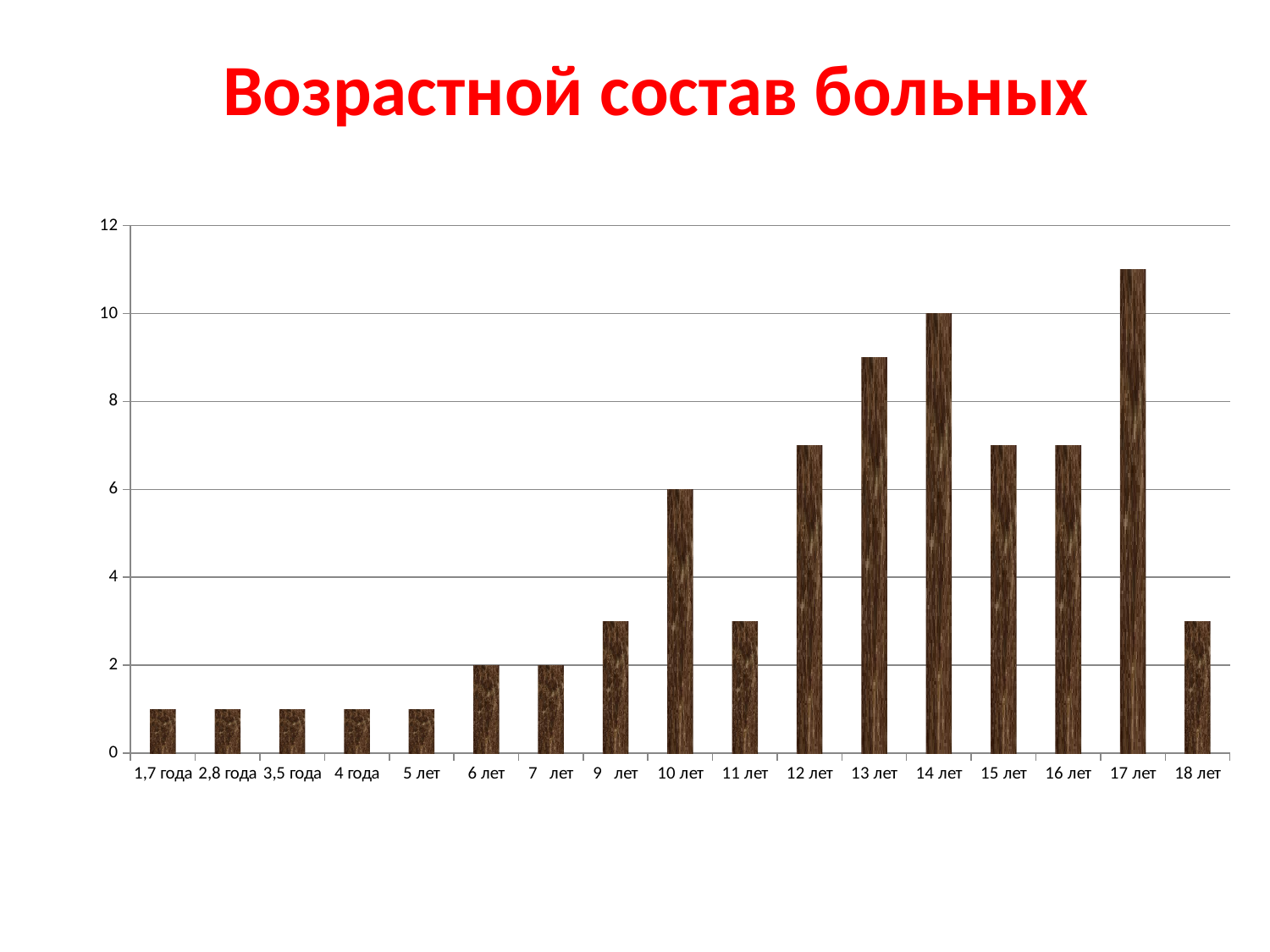
Is the value for 17 лет greater or less than 10? greater What kind of chart is shown on the slide? bar chart What is the value for 14 лет? 10 What is the difference between the values for 14 лет and 10 лет? 4 How many age categories are shown on the x axis? 17 Which is larger, the value for 13 лет or the value for 12 лет? 13 лет Is the value for 18 лет greater or less than 4? less What is the value for 10 лет? 6 Which age category has the highest value? 17 лет What is the title of the chart? Возрастной состав больных Is the value for 13 лет greater or less than 8? greater What is the value for 6 лет? 2